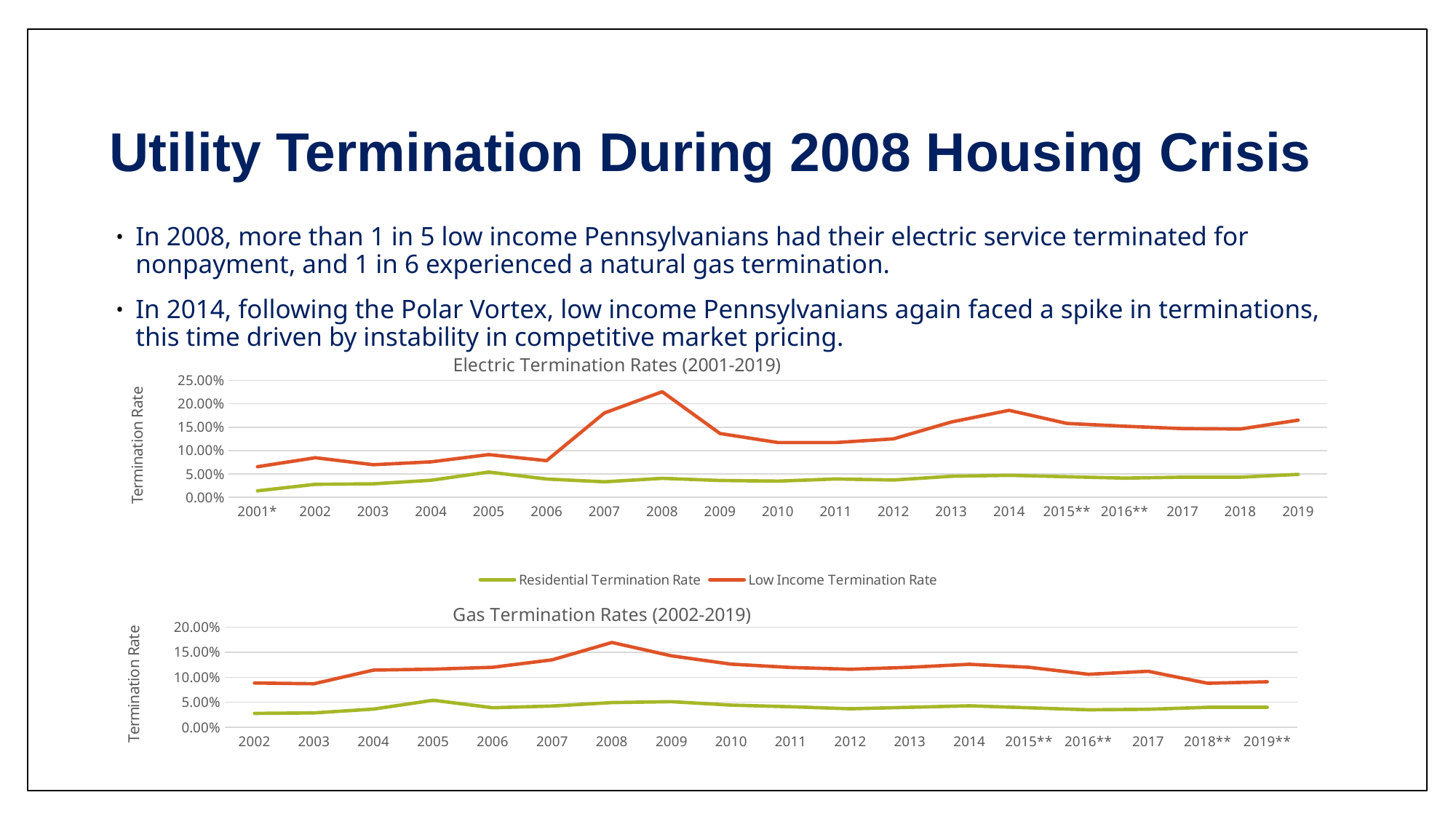
How many series does the legend list for the Electric Termination Rates (2001-2019) chart? 2 How many years are plotted on the x axis of the Electric Termination Rates (2001-2019) chart? 19 In the Electric Termination Rates (2001-2019) chart, does the Low Income Termination Rate rise or fall from 2008 to 2010? fall In the Electric Termination Rates (2001-2019) chart, in which year is the Low Income Termination Rate lowest? 2001* What kind of chart is the Electric Termination Rates (2001-2019) chart? line chart In the Gas Termination Rates (2002-2019) chart, is the Low Income Termination Rate for 2008 greater or less than 15.00%? greater In the Electric Termination Rates (2001-2019) chart, is the Low Income Termination Rate for 2008 greater or less than 20.00%? greater In the Gas Termination Rates (2002-2019) chart, which year has the larger Low Income Termination Rate, 2008 or 2014? 2008 How many years are plotted on the x axis of the Gas Termination Rates (2002-2019) chart? 18 In the Gas Termination Rates (2002-2019) chart, in which year is the Low Income Termination Rate highest? 2008 In the Electric Termination Rates (2001-2019) chart, in which year is the Low Income Termination Rate highest? 2008 In the Electric Termination Rates (2001-2019) chart, is the Low Income Termination Rate for 2010 greater or less than 15.00%? less